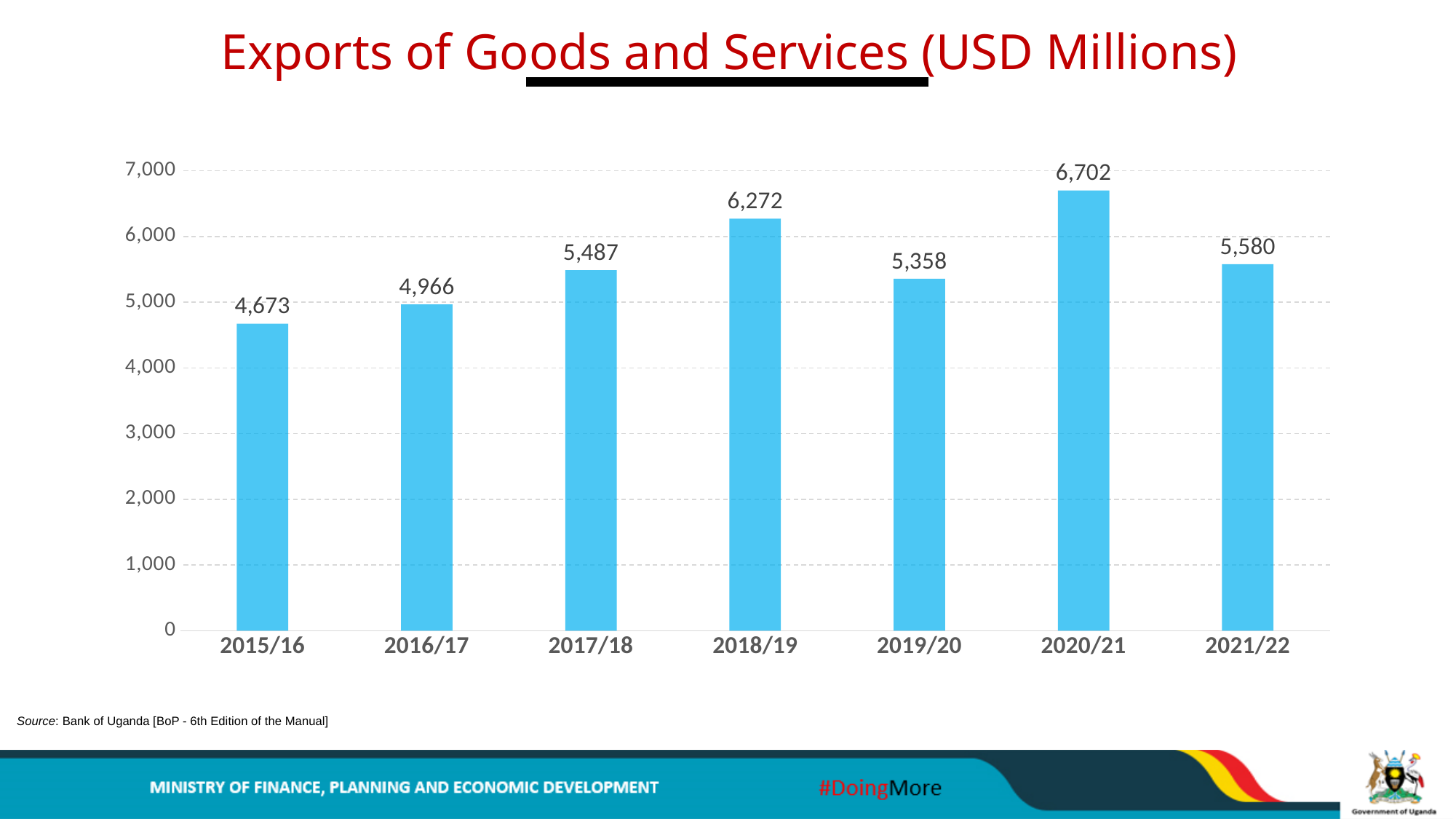
What is the difference between exports in 2018/19 and 2019/20? 914 Which fiscal year has the highest exports of goods and services? 2020/21 What is the value of exports of goods and services for 2015/16? 4,673 Which year had higher exports, 2017/18 or 2019/20? 2017/18 How many fiscal years are shown on the chart? 7 What is the value of exports of goods and services for 2021/22? 5,580 What is the source of the data cited on the slide? Bank of Uganda [BoP - 6th Edition of the Manual] Which fiscal year has the lowest exports of goods and services? 2015/16 What is the difference between exports in 2020/21 and 2021/22? 1,122 Is the value for 2016/17 greater or less than 5,000? less What is the value of exports of goods and services for 2018/19? 6,272 What kind of chart is shown on the slide? Bar chart